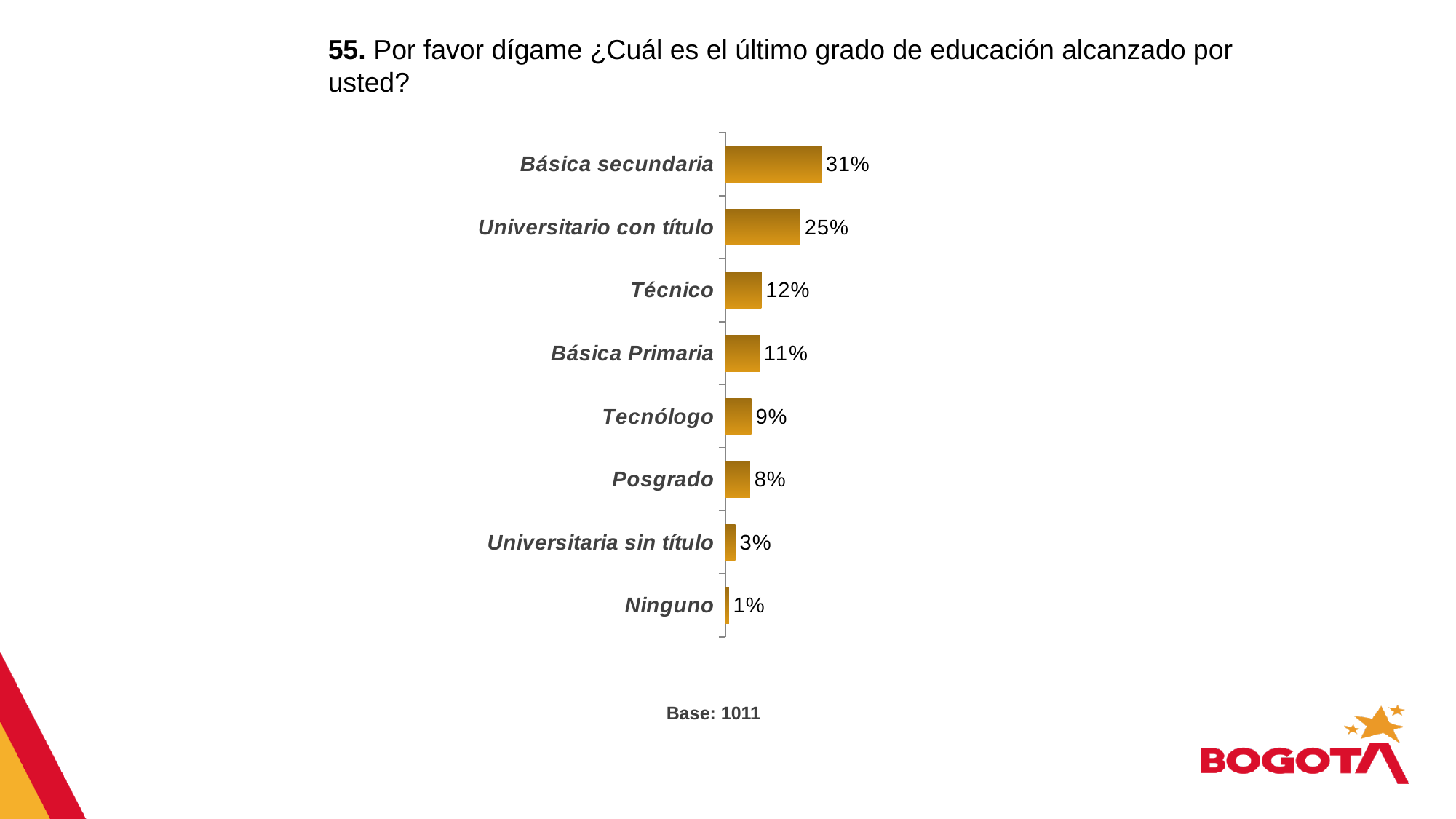
Which category has the lowest value? Ninguno How many categories are shown in the chart? 8 Which is larger, the value for Técnico or the value for Tecnólogo? Técnico What is the value for Universitario con título? 25% What is the difference between the values for Técnico and Posgrado? 4% What kind of chart is shown on the slide? Bar chart Which category has the highest value? Básica secundaria What is the value for Básica secundaria? 31% What is the value for Tecnólogo? 9% What is the value for Universitaria sin título? 3% What is the base (number of respondents) shown below the chart? 1011 What is the difference between the values for Básica secundaria and Universitario con título? 6%